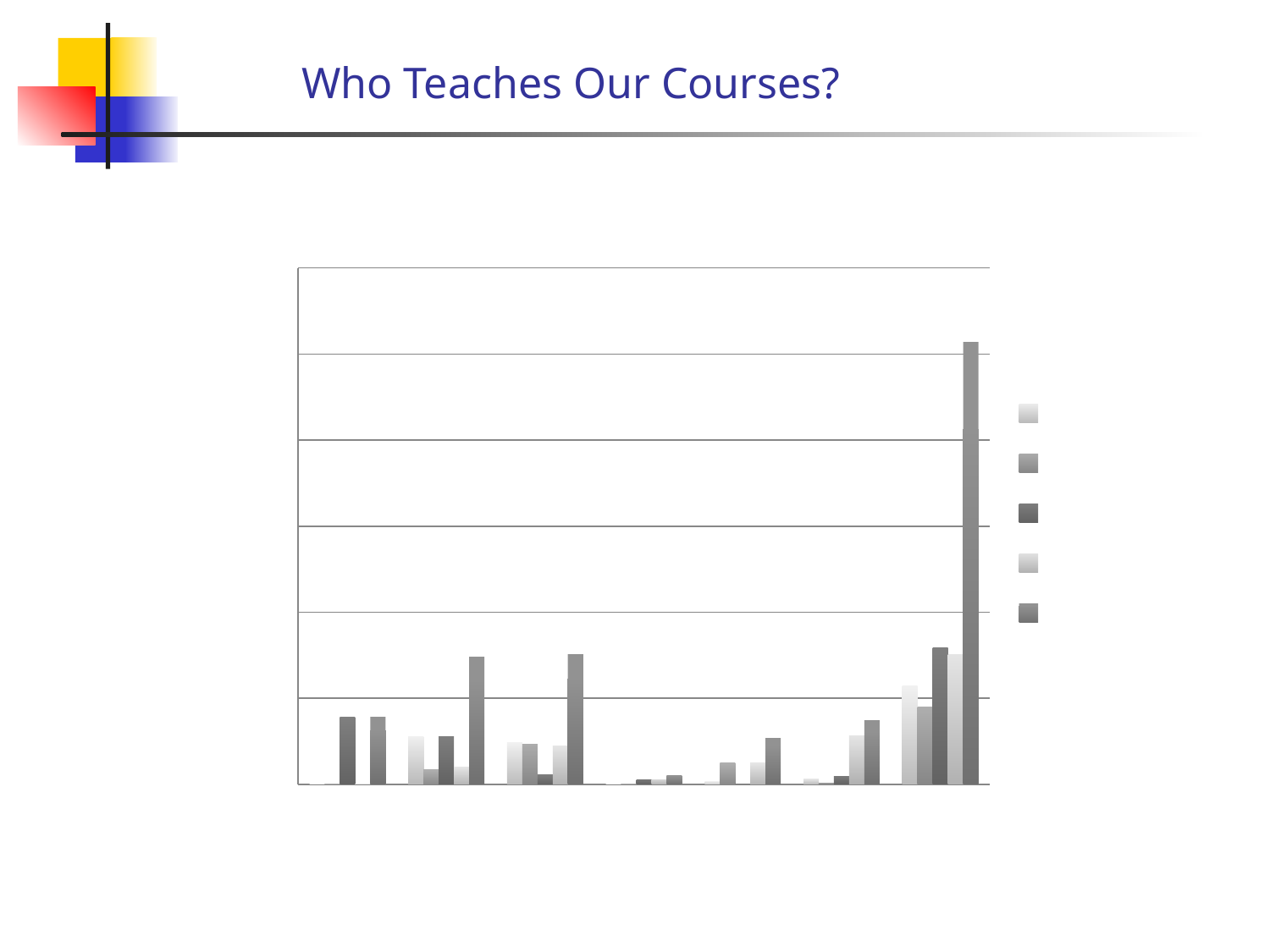
What kind of chart is shown on the slide? bar chart What is the title of the slide containing the chart? Who Teaches Our Courses? How many series does the chart's legend list? 5 In which group of bars does the tallest bar in the chart appear? the rightmost group Are the bars in the chart vertical or horizontal? vertical How many groups of bars (categories) are plotted along the x axis? 7